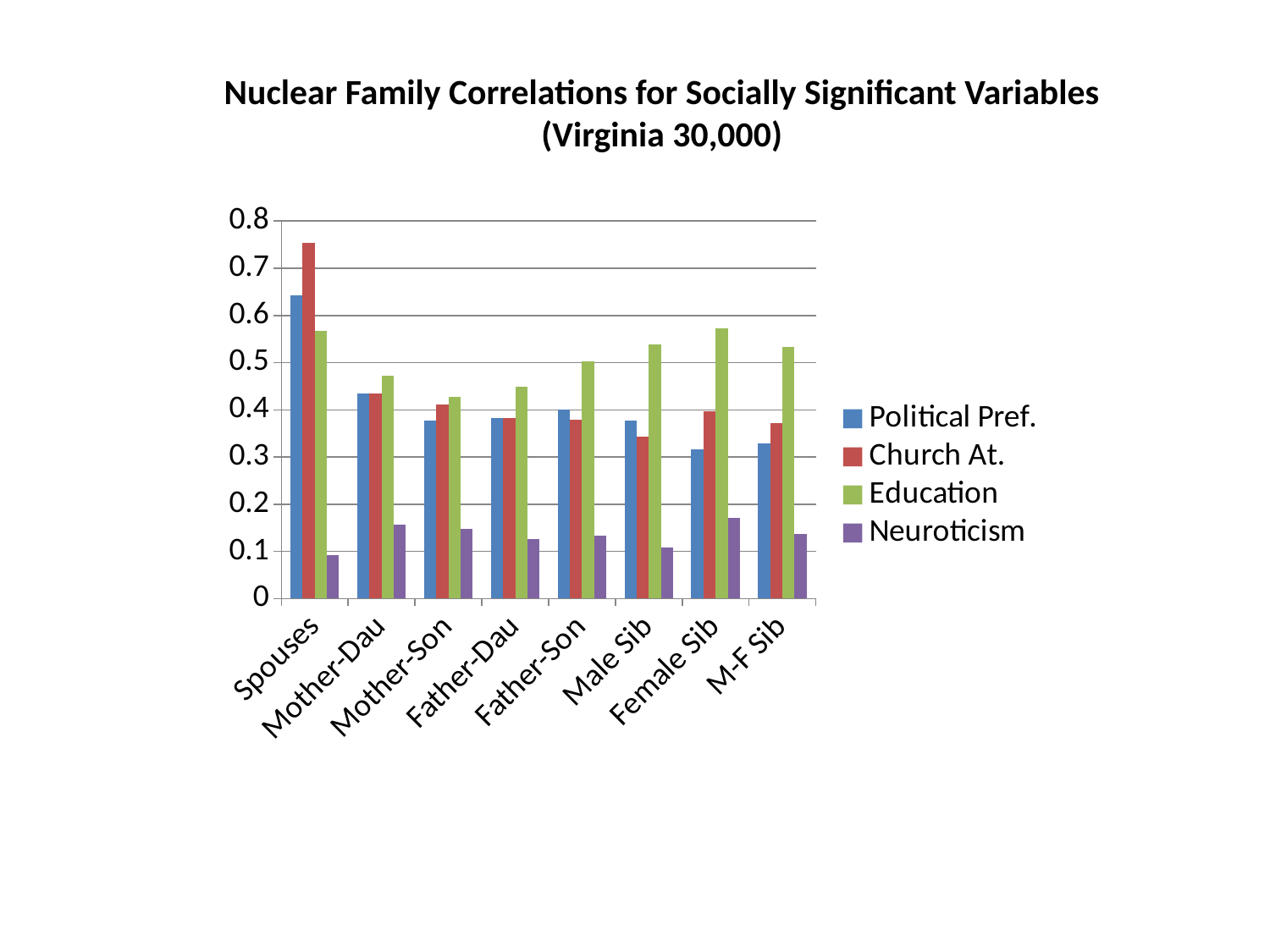
Is the Education value for Male Sib greater or less than 0.5? greater Is the Political Pref. value for Female Sib greater or less than 0.4? less Is the Church At. value for Spouses greater or less than 0.7? greater How many family-pair categories are shown on the x axis? 8 How many series does the legend list? 4 What is the title of the chart? Nuclear Family Correlations for Socially Significant Variables (Virginia 30,000) Which category has the highest Political Pref. correlation? Spouses What kind of chart is shown on the slide? bar chart Which category has the lowest Neuroticism correlation? Spouses Which category has the highest Church At. correlation? Spouses For Spouses, which is larger: the Church At. value or the Political Pref. value? Church At.